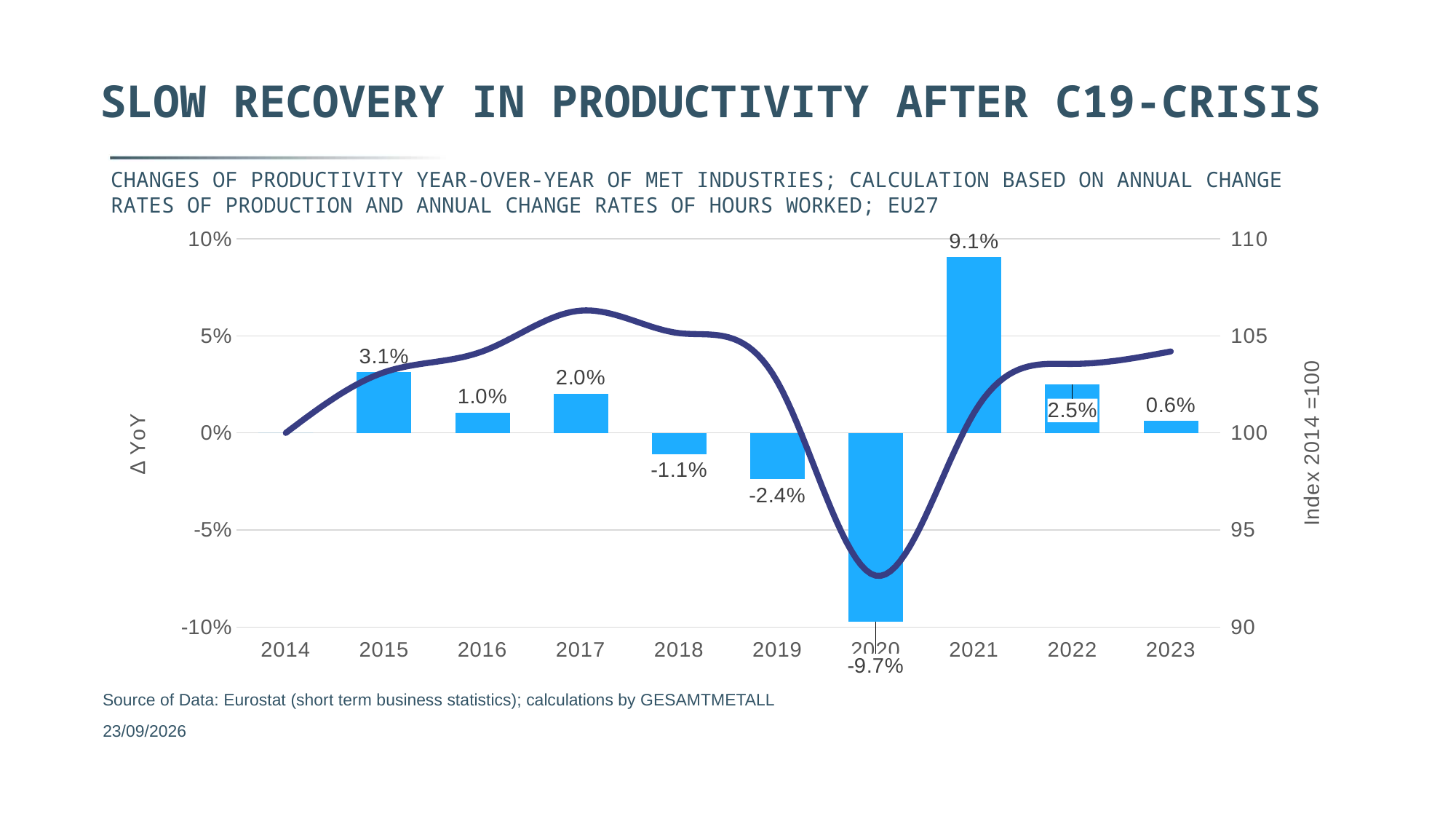
What is the value of the bar for 2019? -2.4% What is the label of the right-hand vertical axis? Index 2014 =100 What kind of chart is this? Combined bar and line chart Which is larger, the bar for 2017 or the bar for 2016? 2017 Which year has the highest year-over-year change? 2021 How many years are shown on the x axis? 10 Is the index line value for 2017 greater or less than 105? greater Is the index line value for 2020 greater or less than 95? less What is the value of the bar for 2022? 2.5% Which year has the lowest year-over-year change? 2020 What is the difference between the 2021 value and the 2015 value? 6.0 percentage points What is the year-over-year productivity change shown for 2021? 9.1%